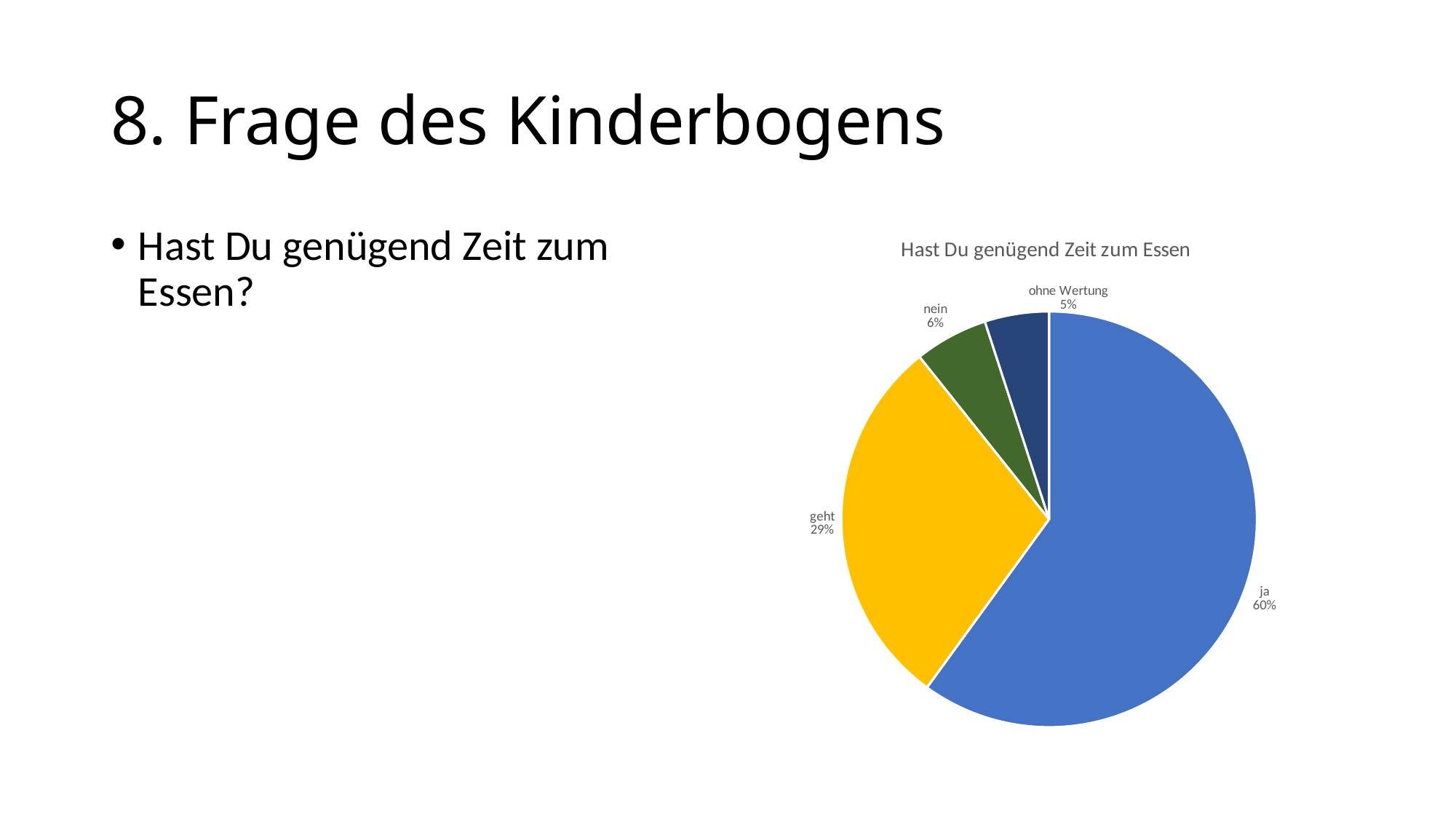
What share of the pie does "ohne Wertung" have? 5% How many slices does the pie chart have? 4 What share of the pie does "nein" have? 6% What share of the pie does "ja" have? 60% Which category has the largest slice? ja What kind of chart is shown on the slide? pie chart What is the difference in percentage points between "ja" and "geht"? 31 What colour is the slice for "geht"? yellow Which category has the smallest slice? ohne Wertung What is the title of the chart? Hast Du genügend Zeit zum Essen Which is larger, the slice for "geht" or the slice for "nein"? geht